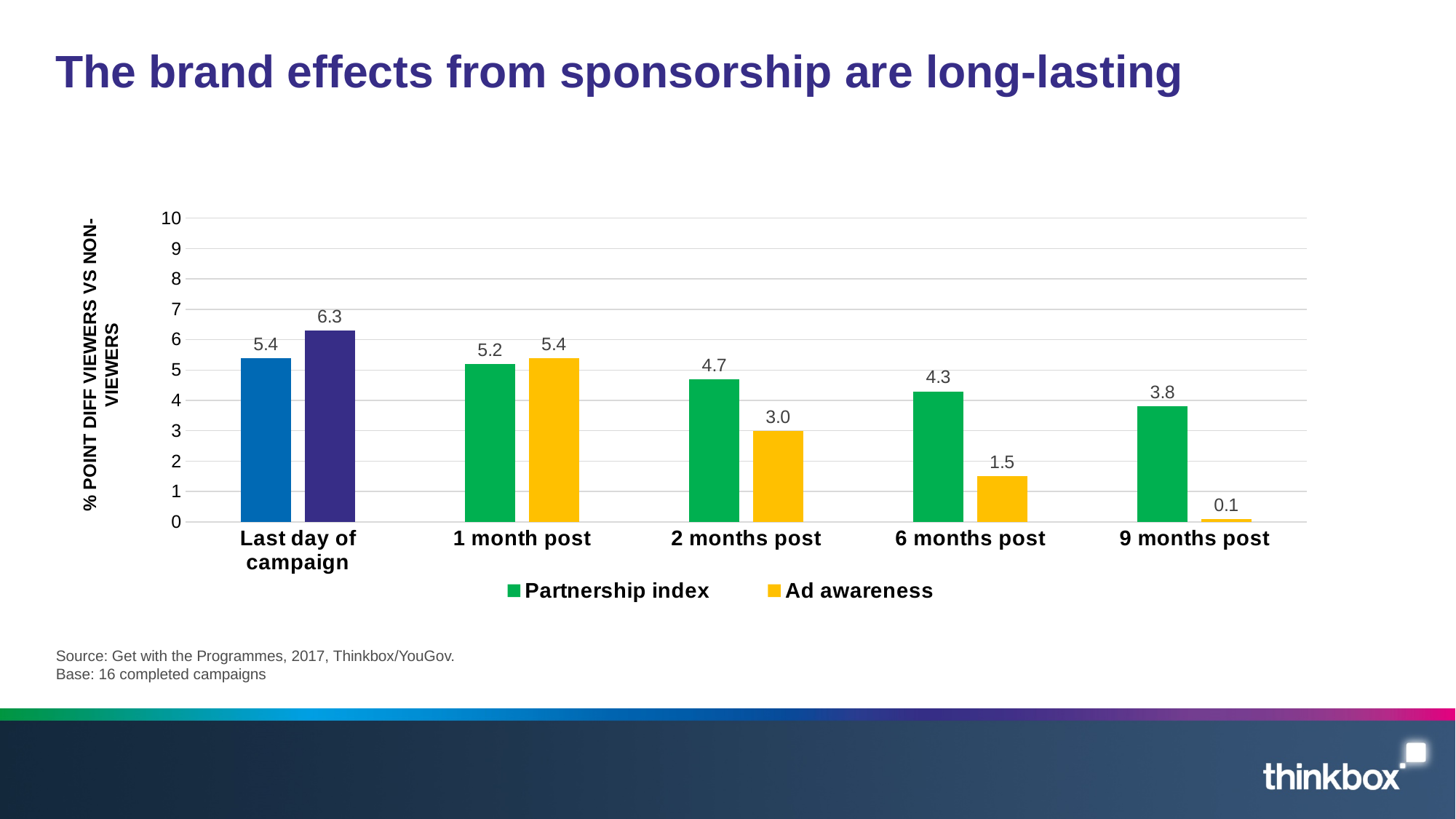
Which category has the lowest Partnership index value? 9 months post What is the Partnership index value for 2 months post? 4.7 What kind of chart is shown on the slide? bar chart What is the Ad awareness value for 9 months post? 0.1 Which is larger at 6 months post, Partnership index or Ad awareness? Partnership index What is the difference between the Partnership index and Ad awareness values for 2 months post? 1.7 What is the value of the second (right-hand) bar for Last day of campaign? 6.3 How many categories are shown on the x axis? 5 Do the Ad awareness values rise or fall from Last day of campaign to 9 months post? fall What is the Ad awareness value for 6 months post? 1.5 Which category has the highest Ad awareness value? Last day of campaign How many series does the legend list? 2